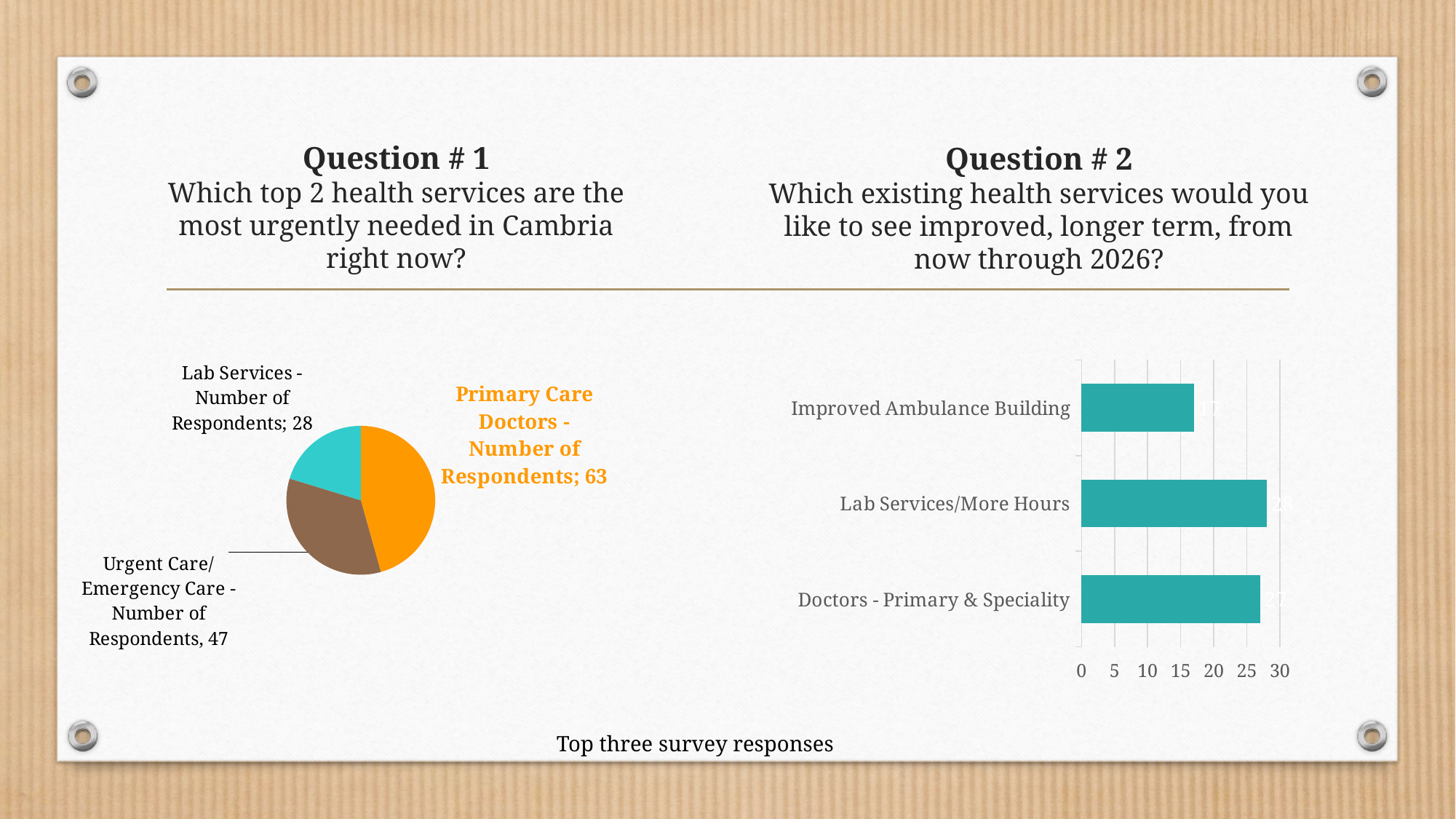
In the bar chart for Question # 2, is the value for Improved Ambulance Building greater or less than 20? less In the pie chart for Question # 1, which service has the fewest respondents? Lab Services In the pie chart for Question # 1, which service has the most respondents? Primary Care Doctors In the pie chart for Question # 1, how many respondents chose Urgent Care/Emergency Care? 47 In the pie chart for Question # 1, how many respondents chose Primary Care Doctors? 63 In the bar chart for Question # 2, which category has the lowest value? Improved Ambulance Building In the bar chart for Question # 2, how many categories are shown? 3 In the pie chart for Question # 1, how many more respondents chose Primary Care Doctors than Urgent Care/Emergency Care? 16 What kind of chart is shown for Question # 2? bar chart In the bar chart for Question # 2, is the value for Lab Services/More Hours greater or less than 25? greater In the pie chart for Question # 1, how many slices are there? 3 In the pie chart for Question # 1, how many respondents chose Lab Services? 28